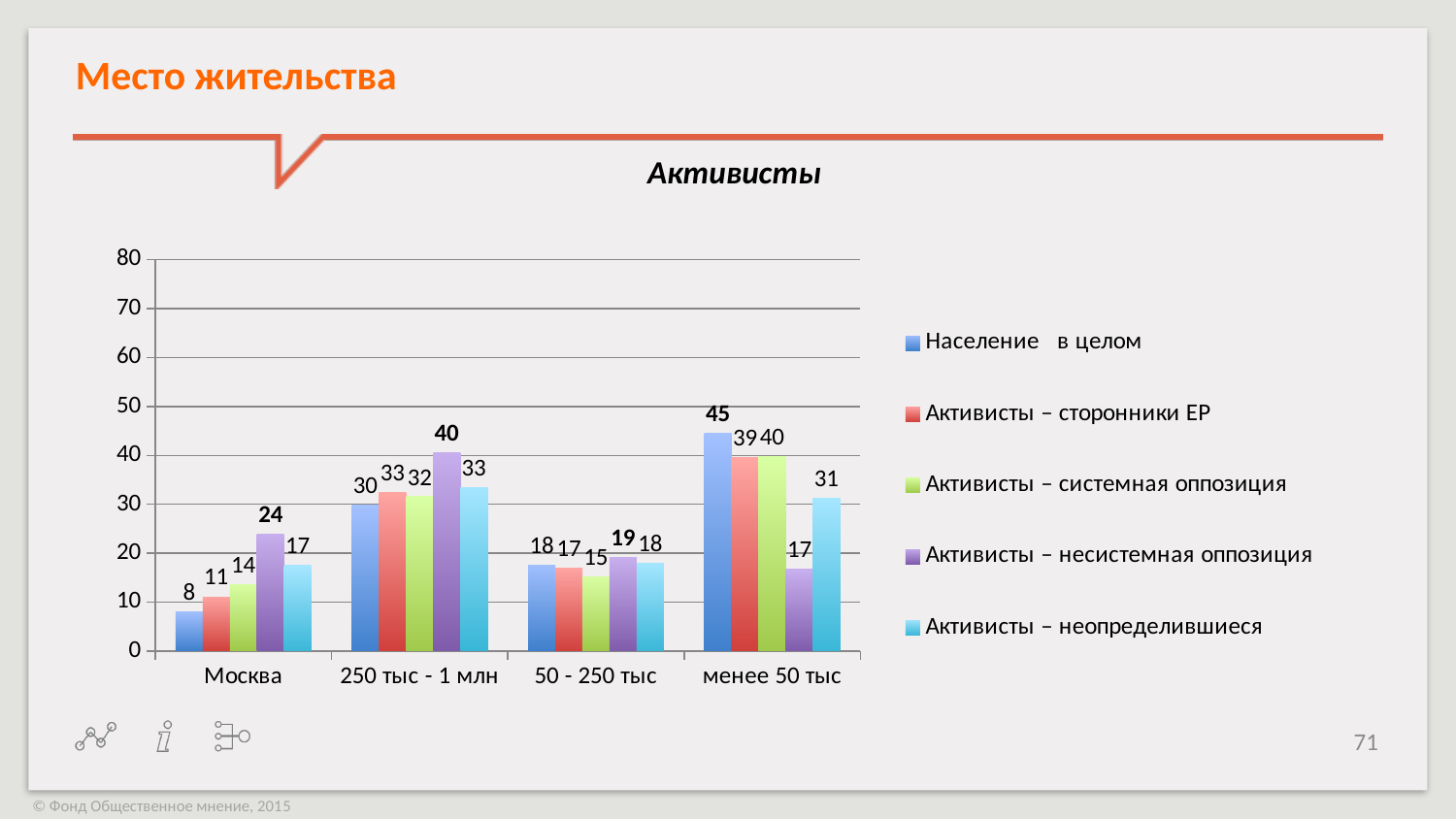
What is the difference between Население в целом and Активисты – несистемная оппозиция in the менее 50 тыс category? 28 What is the value for Население в целом in the Москва category? 8 What kind of chart is shown on the slide? bar chart Which series has the highest value in the менее 50 тыс category? Население в целом Which is larger in the 250 тыс - 1 млн category: Активисты – сторонники ЕР or Население в целом? Активисты – сторонники ЕР Is the value for Активисты – несистемная оппозиция in the Москва category greater or less than 20? greater What is the value for Активисты – неопределившиеся in the менее 50 тыс category? 31 How many series does the legend list? 5 How many categories are shown on the x axis? 4 What is the title shown above the chart? Активисты What is the value for Активисты – несистемная оппозиция in the 250 тыс - 1 млн category? 40 Which series has the lowest value in the Москва category? Население в целом